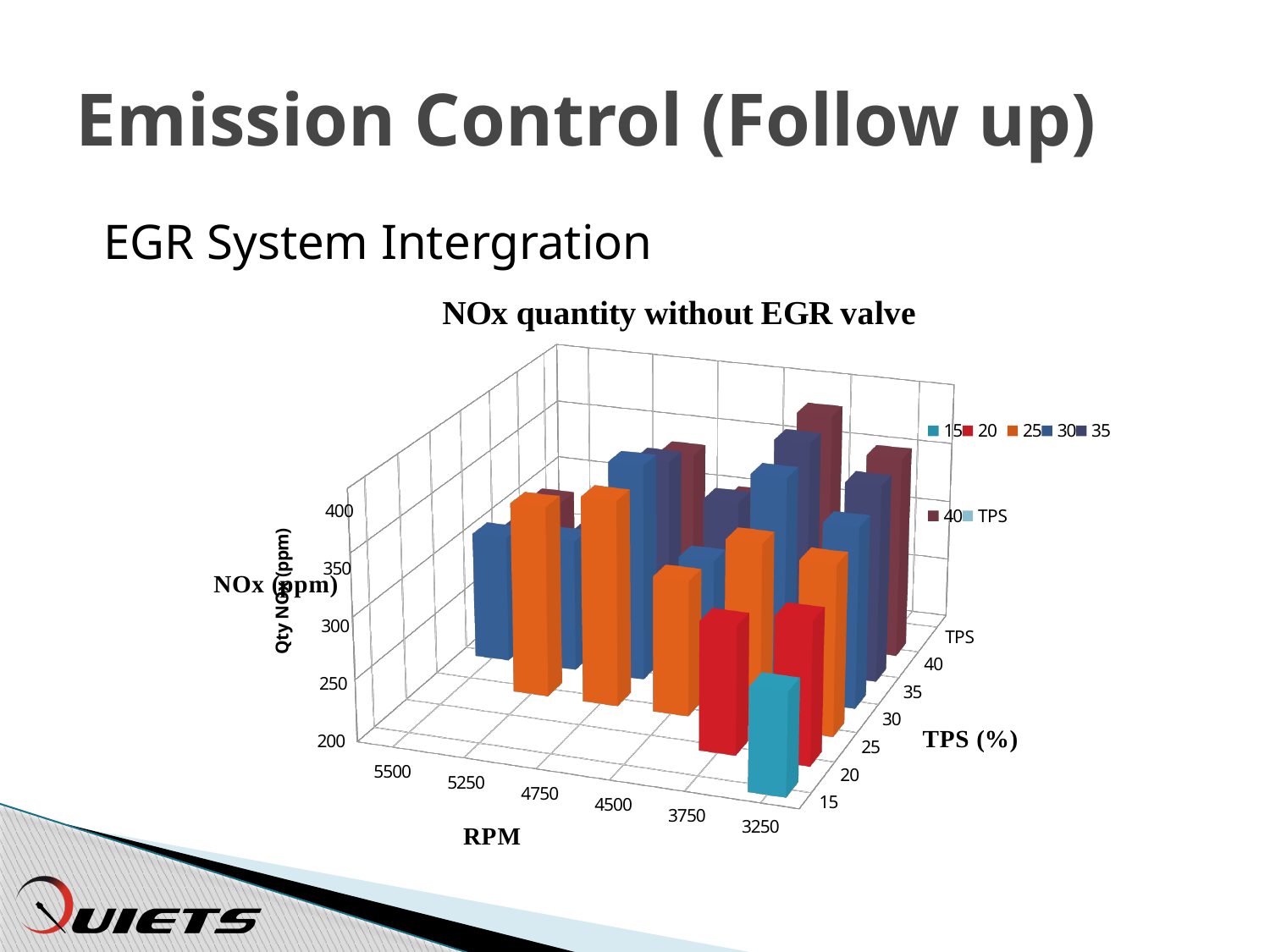
What is the title of the chart? NOx quantity without EGR valve How many RPM categories are shown along the RPM axis? 6 What is the label of the vertical axis of the chart? NOx (ppm) What is the highest tick value shown on the NOx (ppm) axis? 400 What is the highest RPM value shown on the RPM axis? 5500 Which TPS series has the lowest bar in the chart? 15 What kind of chart is shown on the slide? bar chart What is the lowest tick value shown on the NOx (ppm) axis? 200 What is the lowest RPM value shown on the RPM axis? 3250